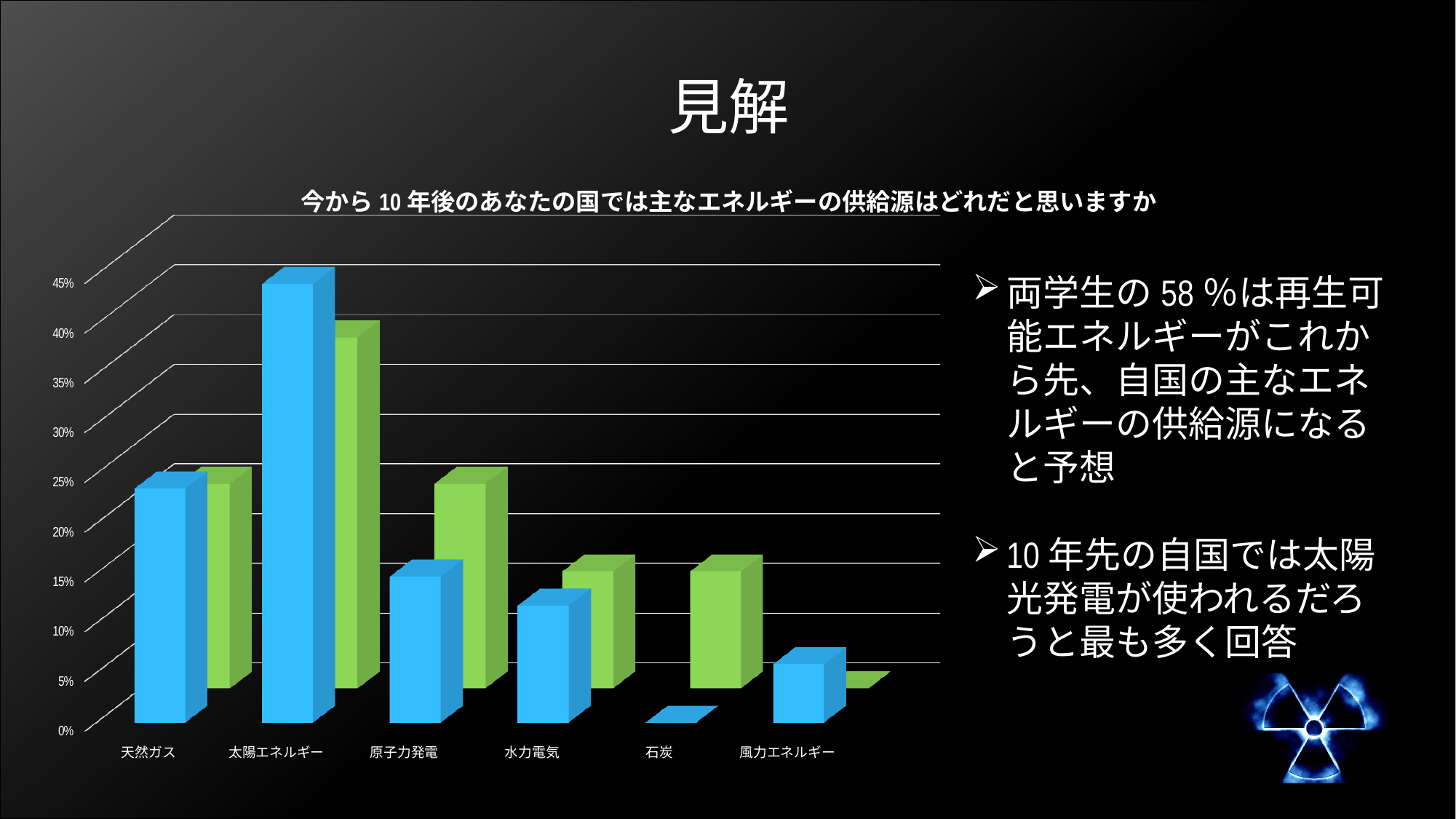
Which is larger, the blue bar for 太陽エネルギー or the blue bar for 原子力発電? 太陽エネルギー How many categories are shown on the x axis of the chart? 6 Which category has the highest blue bar in the chart? 太陽エネルギー Which category has the lowest blue bar in the chart? 石炭 What is the title of the chart? 今から10年後のあなたの国では主なエネルギーの供給源はどれだと思いますか Is the blue bar for 風力エネルギー greater or less than 10%? less Which category has the lowest green bar in the chart? 風力エネルギー Which is larger, the green bar for 原子力発電 or the green bar for 水力電気? 原子力発電 Is the blue bar for 太陽エネルギー greater or less than 40%? greater Which category has the highest green bar in the chart? 太陽エネルギー Is the blue bar for 天然ガス greater or less than 20%? greater What kind of chart is shown on the slide? bar chart